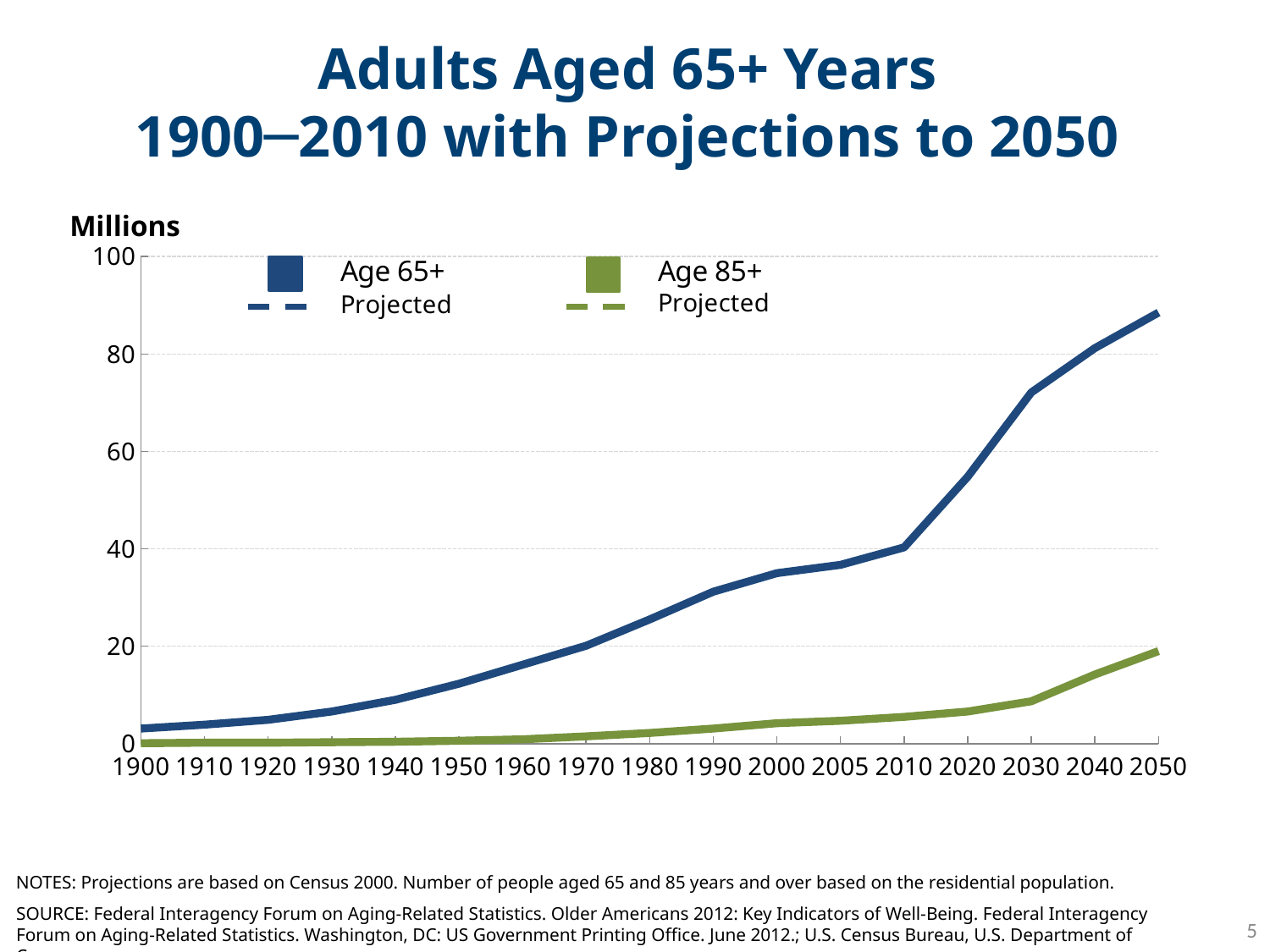
Is the value for Age 85+ in 2050 greater or less than 40? less Is the value for Age 65+ in 2050 greater or less than 80? greater How many age groups does the legend list? 2 Is the value for Age 85+ in 2050 greater or less than 10? greater What kind of chart is shown on the slide? Line chart In 2050, which series has the larger value, Age 65+ or Age 85+? Age 65+ How many years are labelled along the x axis? 17 Does the Age 65+ line rise or fall from 1900 to 2050? Rises What unit is shown for the y axis? Millions In which year does the Age 65+ line reach its highest value? 2050